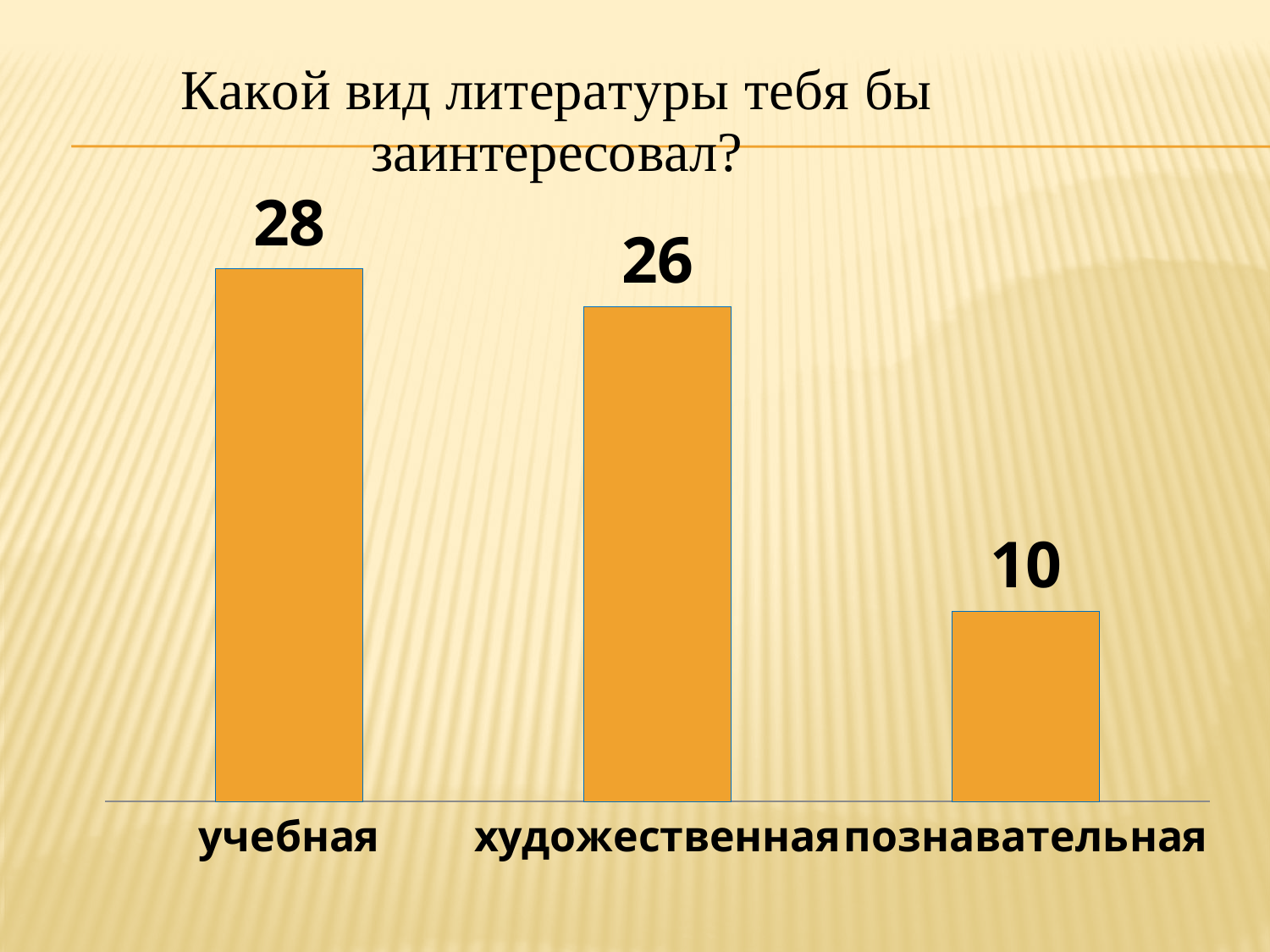
Do the values rise or fall from left to right across the categories? fall What kind of chart is shown on the slide? bar chart What is the value for художественная? 26 Which is larger, the value for художественная or the value for познавательная? художественная How many categories are shown in the chart? 3 What is the value for учебная? 28 What is the difference between the values for учебная and художественная? 2 What is the value for познавательная? 10 Which category has the lowest value? познавательная What is the difference between the values for учебная and познавательная? 18 What is the title of the slide above the chart? Какой вид литературы тебя бы заинтересовал? Which category has the highest value? учебная